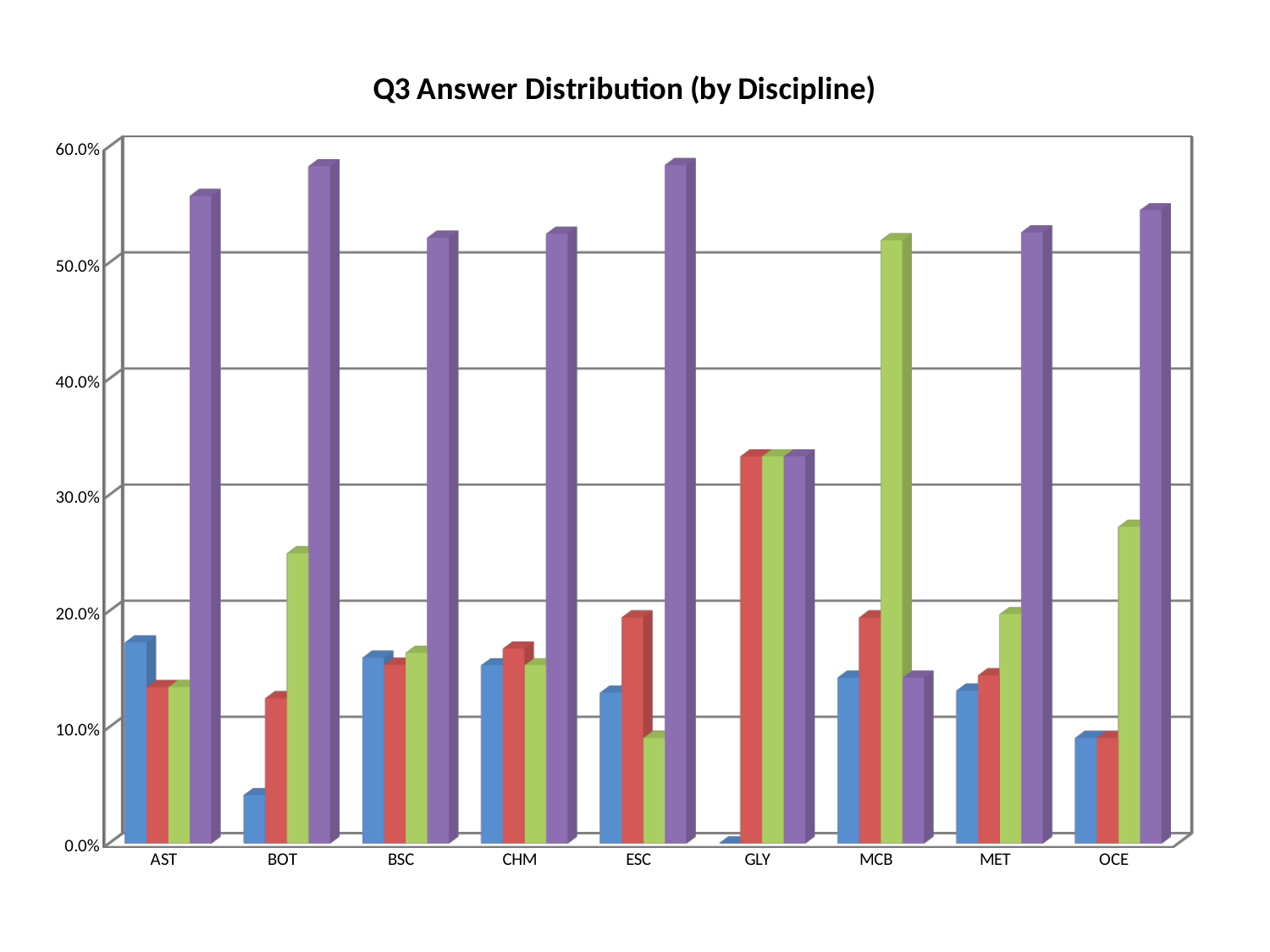
Which discipline has the highest green bar? MCB For BOT, which is larger, the blue bar or the red bar? red Is the purple bar for AST greater or less than 50.0%? greater Is the blue bar for BOT greater or less than 10.0%? less How many bars (colours) are plotted for each discipline? 4 Which discipline has the lowest purple bar? MCB How many disciplines are shown on the x axis? 9 Which discipline has the highest red bar? GLY What is the title of the chart? Q3 Answer Distribution (by Discipline) For MCB, which is larger, the green bar or the purple bar? green What kind of chart is shown on the slide? bar chart Which discipline has the lowest green bar? ESC